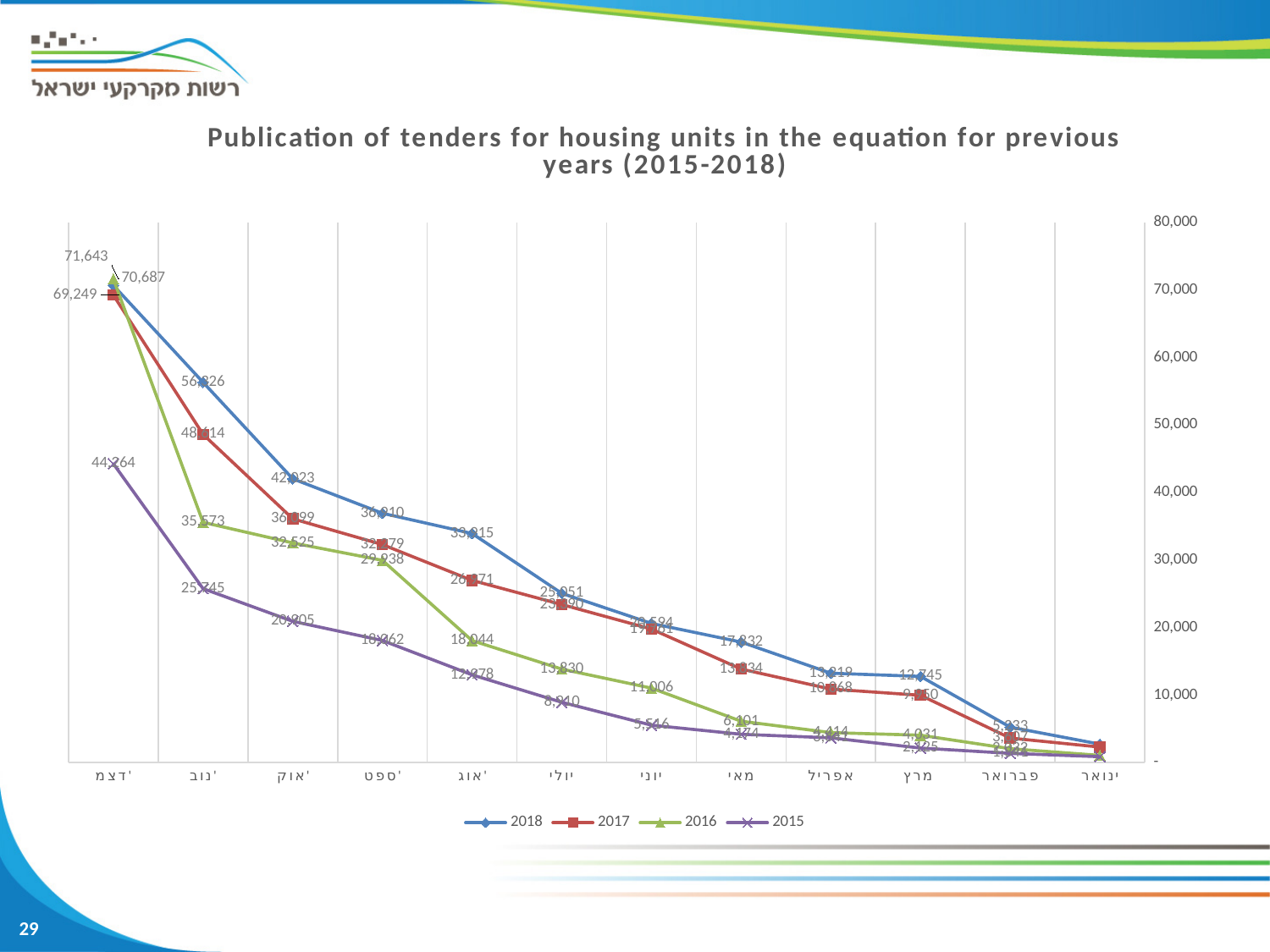
What kind of chart is shown on the slide? line chart How many series does the legend list? 4 What is the value for the 2016 series at דצמ'? 71,643 What is the value for the 2018 series at נוב'? 56,326 What is the value for the 2015 series at דצמ'? 44,264 What is the difference between the 2018 and 2017 values at דצמ'? 1,438 Which series has the lowest value at דצמ'? 2015 What is the value for the 2016 series at אוג'? 18,044 Is the value for the 2015 series at נוב' greater or less than 20,000? greater What is the value for the 2015 series at יולי? 8,910 Do the values of the 2018 series rise or fall moving from left (דצמ') to right (ינואר) along the x axis? fall How many categories are on the x axis? 12